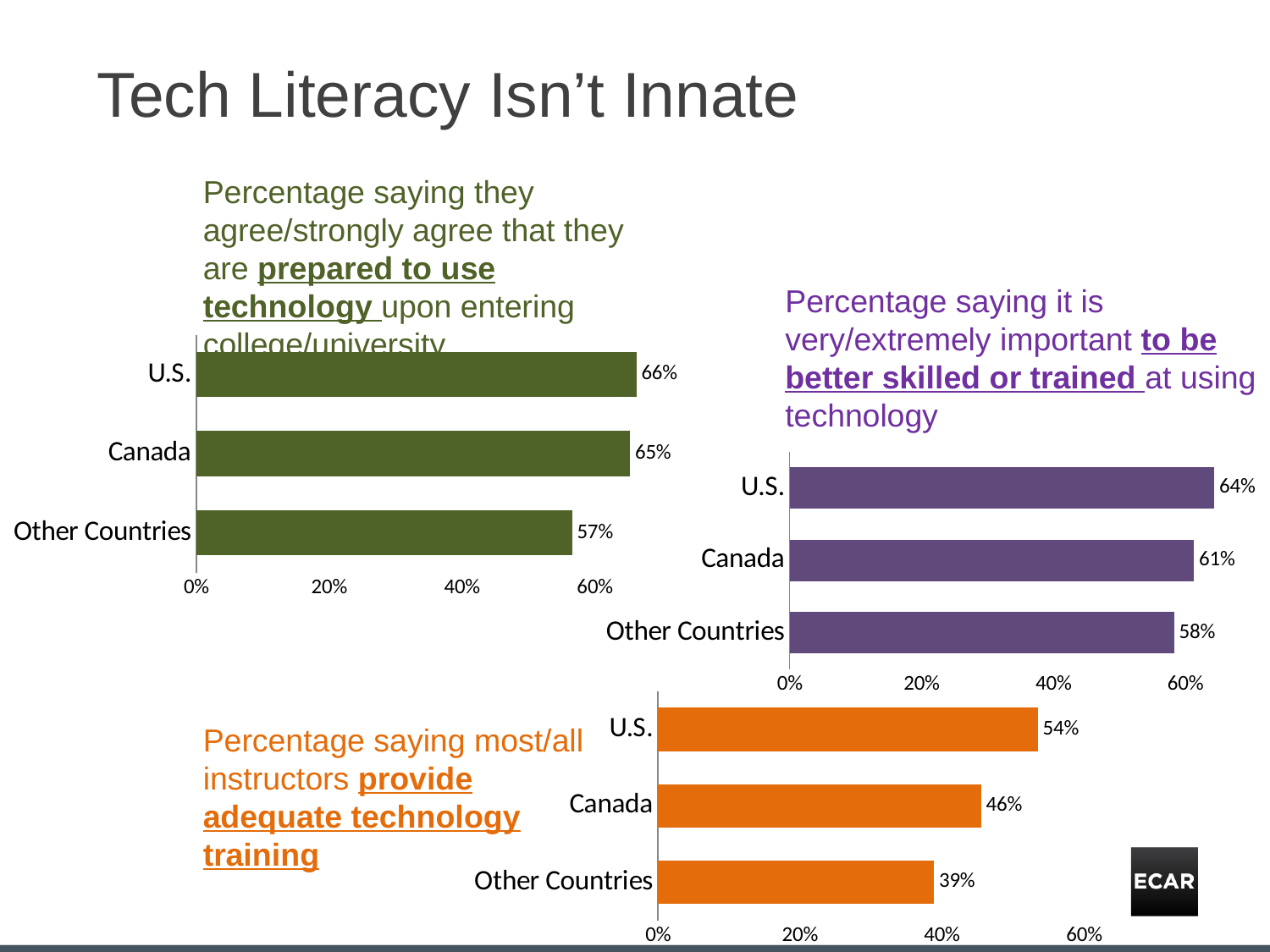
In the orange chart (provide adequate technology training), what is the value for Other Countries? 39% In the purple chart (better skilled or trained), which category has the lowest value? Other Countries In the orange chart (provide adequate technology training), is the value for Canada greater or less than 40%? greater In the purple chart (better skilled or trained), what is the value for Canada? 61% In the green chart (prepared to use technology), what is the value for Other Countries? 57% What type of chart is the purple chart (better skilled or trained)? Bar chart In the green chart (prepared to use technology), what is the value for the U.S.? 66% In the purple chart (better skilled or trained), what is the difference between the U.S. and Other Countries values? 6% In the orange chart (provide adequate technology training), which category has the highest value? U.S. In the orange chart (provide adequate technology training), what is the difference between the U.S. and Canada values? 8% How many categories does the green chart (prepared to use technology) show? 3 In the green chart (prepared to use technology), is the value for Canada or Other Countries larger? Canada